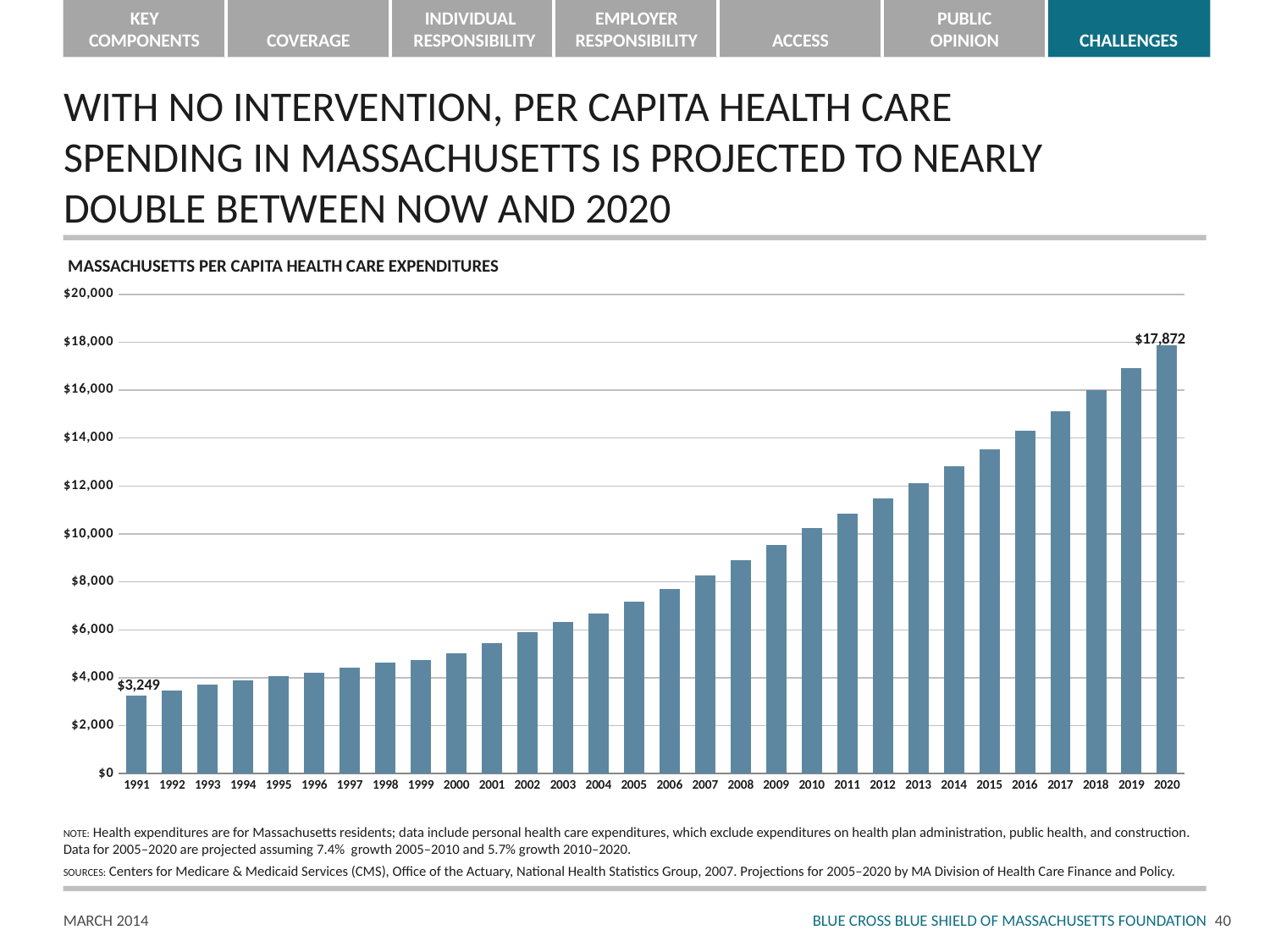
Is the value for 2015 greater or less than $12,000? greater Which year has the lowest per capita health care expenditure in the chart? 1991 What is the projected per capita health care expenditure shown for 2020? $17,872 What kind of chart is used to show Massachusetts per capita health care expenditures? Bar chart Do the per capita expenditure values rise or fall from 1991 to 2020? Rise Which year has a larger per capita expenditure, 2000 or 2010? 2010 What is the per capita health care expenditure shown for 1991? $3,249 Which year has the highest per capita health care expenditure in the chart? 2020 Is the value for 2005 greater or less than $8,000? less What is the difference between the 2020 value and the 1991 value? $14,623 What is the title of the chart? MASSACHUSETTS PER CAPITA HEALTH CARE EXPENDITURES How many years are shown on the x axis of the chart? 30